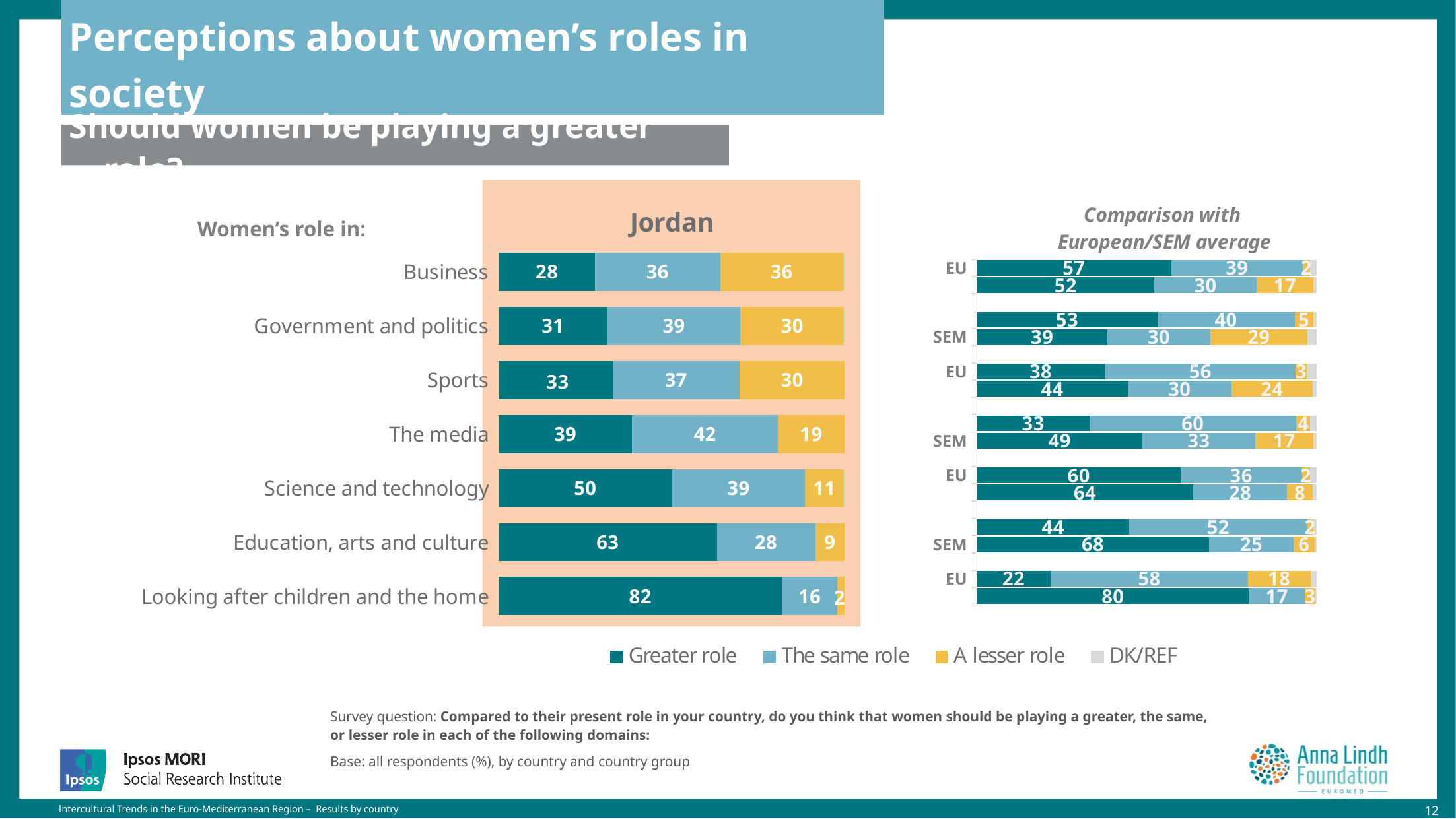
In the Jordan chart, what is the value for 'The same role' in The media? 42 In the Jordan chart, what is the difference between the 'Greater role' values for Education, arts and culture and Sports? 30 In the Jordan chart, what percentage say women should play a greater role in Business? 28 In the Jordan chart, what is the total of the three labelled segments for Government and politics? 100 In the Jordan chart, which domain has the lowest 'Greater role' value? Business In the Jordan chart, which domain has the highest 'Greater role' value? Looking after children and the home In the Jordan chart, what is the value for 'A lesser role' in Science and technology? 11 How many domains are listed in the Jordan chart? 7 How many series does the legend list? 4 What type of chart is the Jordan chart? Stacked bar chart In the Jordan chart, is the 'A lesser role' value larger for Business or for The media? Business What is the title of the chart on the right of the slide? Comparison with European/SEM average